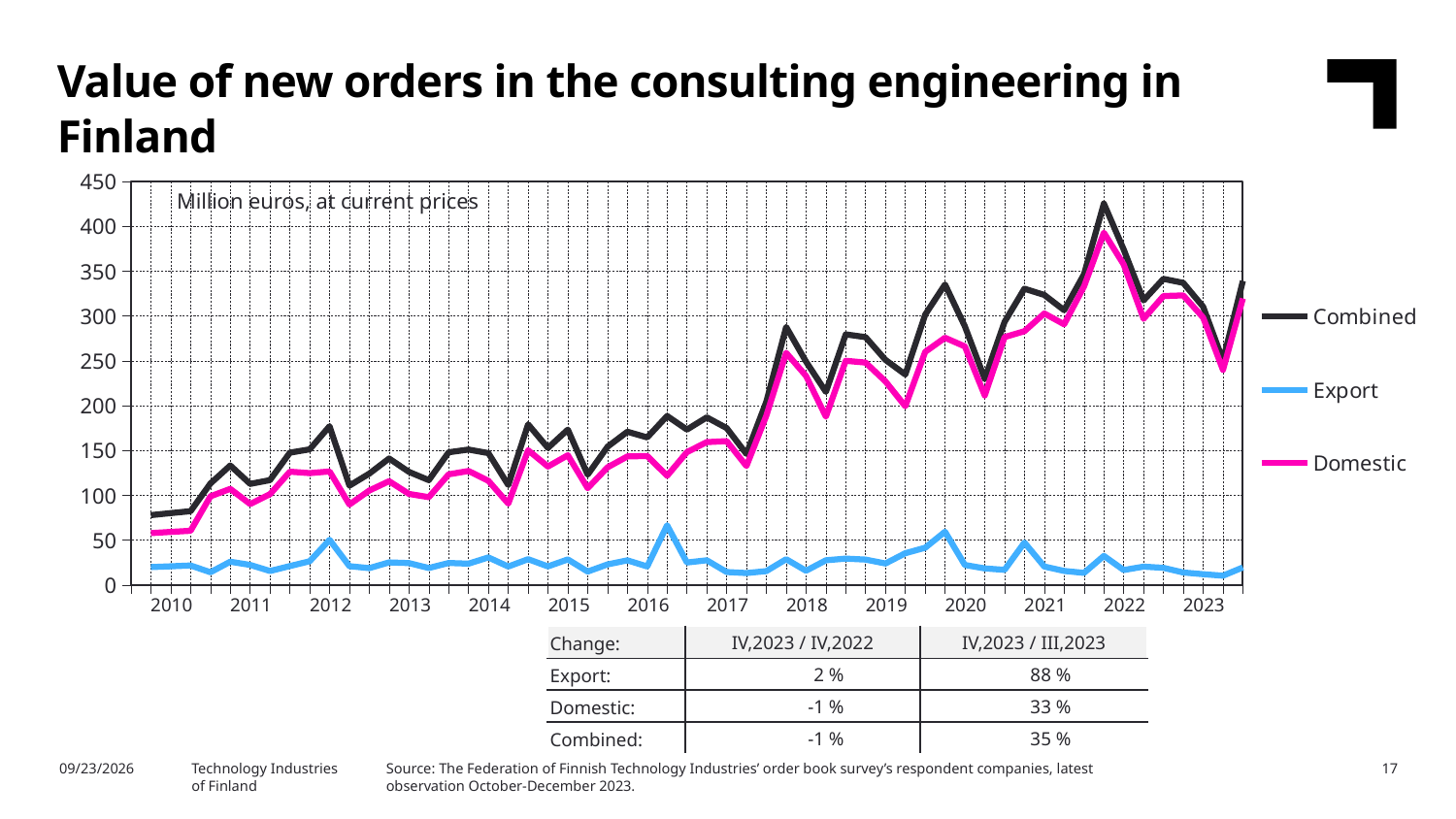
Does the Combined series overall rise or fall from 2010 to 2023? rise How many series does the legend list? 3 Which series has the highest values throughout the chart? Combined Is the value of the Combined series at the start of 2010 greater or less than 100? less What unit label is printed inside the chart area? Million euros, at current prices What kind of chart is shown on the slide? line chart Is the value of the Export series at the start of 2010 greater or less than 50? less Which is larger in 2022, the Domestic series or the Export series? Domestic How many year labels are shown on the x axis? 14 Is the peak value of the Combined series in late 2021 greater or less than 400? greater Which series does the legend list first? Combined Which series has the lowest values throughout the chart? Export